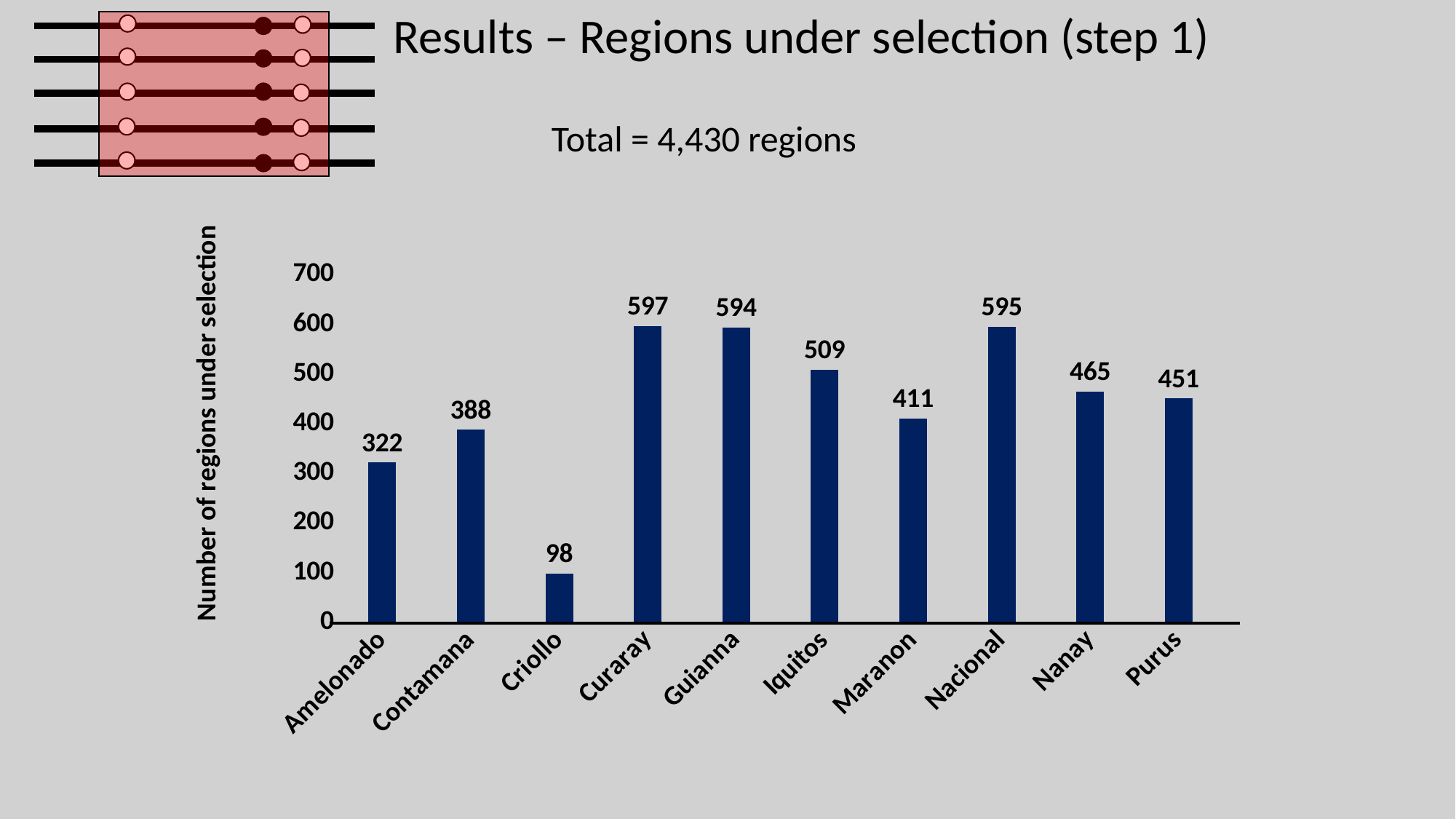
What is the value for Nanay? 465 Which category has the highest number of regions under selection? Curaray Is the value for Nacional greater or less than 500? greater What is the difference between the values for Iquitos and Purus? 58 Which is larger, the value for Maranon or the value for Purus? Purus What is the label of the y axis? Number of regions under selection What is the value for Criollo? 98 Which category has the lowest number of regions under selection? Criollo How many categories are shown on the x axis? 10 How many regions under selection are shown for Iquitos? 509 What is the difference between the values for Contamana and Amelonado? 66 What kind of chart is shown on the slide? bar chart